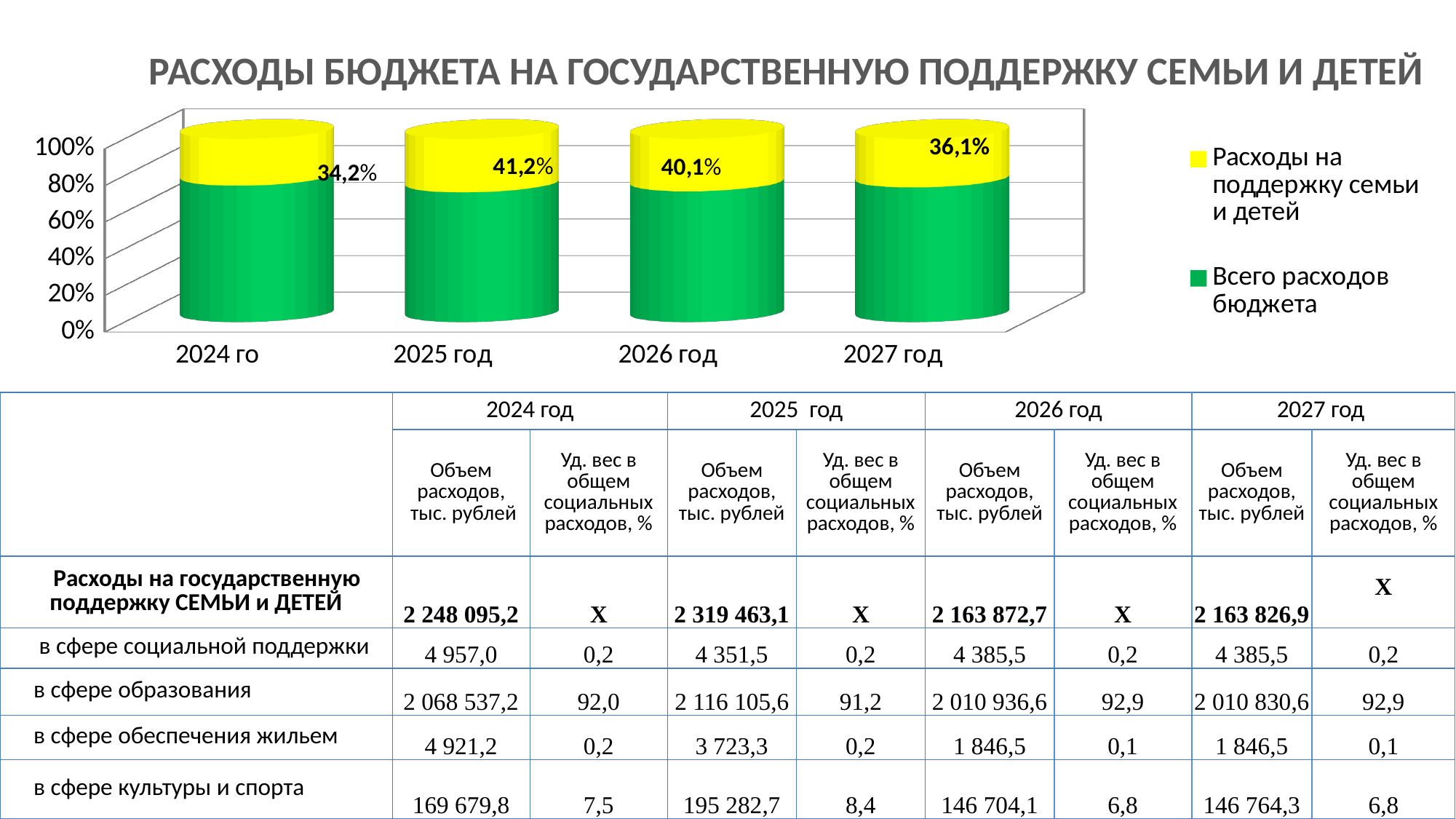
What is the labelled value for 2027 год in the chart? 36,1% What is the difference between the labelled values for 2025 год and 2024 го? 7,0% What is the labelled value for 2025 год in the chart? 41,2% What is the labelled value for 2026 год in the chart? 40,1% How many series does the chart legend list? 2 What is the difference between the labelled values for 2026 год and 2027 год? 4,0% How many years are shown on the x axis of the chart? 4 What is the labelled value for 2024 го in the chart? 34,2% What kind of chart is shown on the slide? Bar chart Which year has the highest labelled value in the chart? 2025 год Which has the larger labelled value, 2026 год or 2027 год? 2026 год Which year has the lowest labelled value in the chart? 2024 го